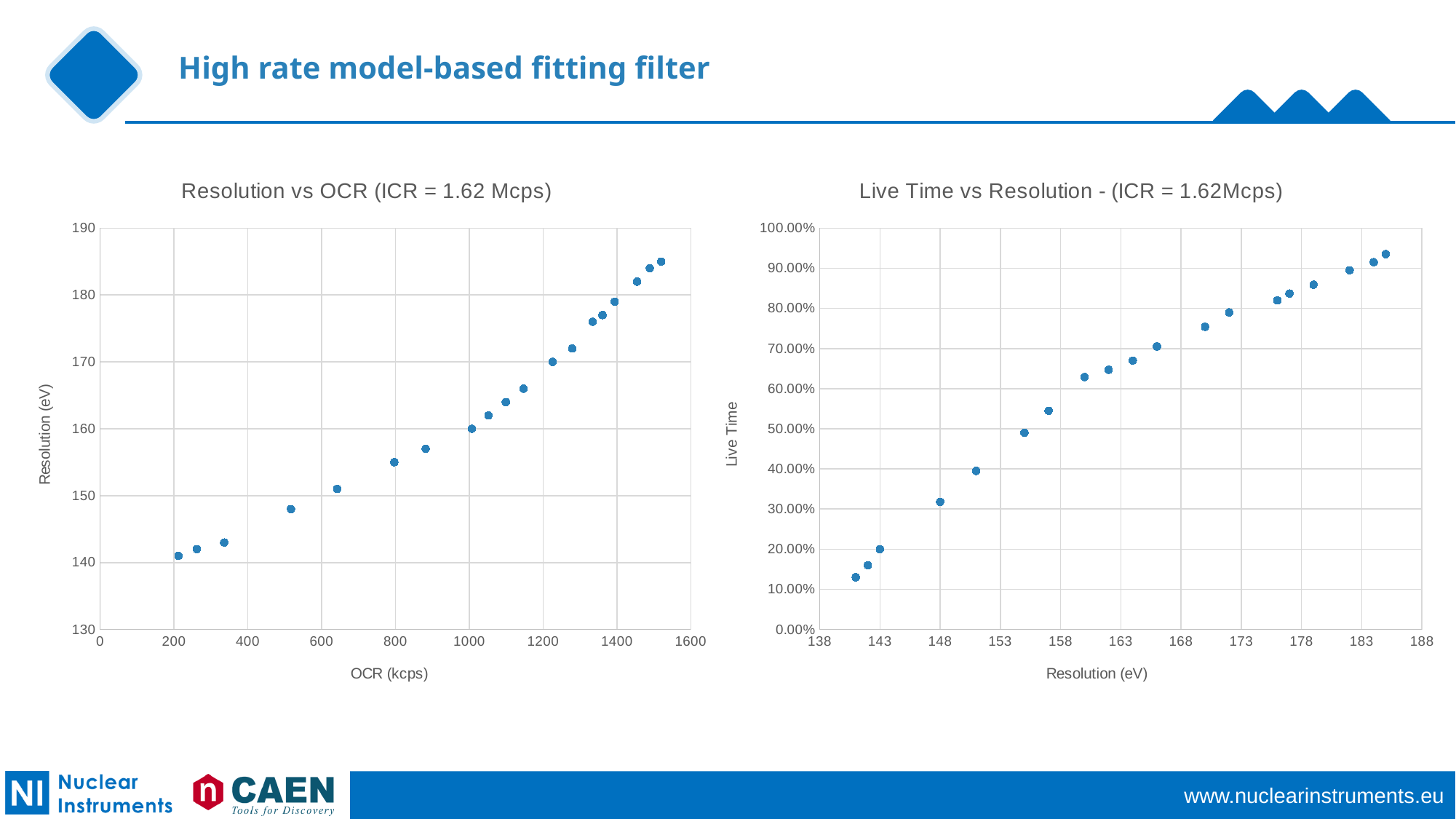
What is the x-axis label of the 'Resolution vs OCR' chart? OCR (kcps) What kind of chart is the 'Resolution vs OCR (ICR = 1.62 Mcps)' chart? scatter chart In the 'Live Time vs Resolution' chart, does live time rise or fall as resolution increases? rise In the 'Resolution vs OCR' chart, is the resolution at the highest OCR (around 1500 kcps) greater or less than 180 eV? greater What kind of chart is the 'Live Time vs Resolution - (ICR = 1.62Mcps)' chart? scatter chart In the 'Live Time vs Resolution' chart, is the live time at the lowest resolution (around 141 eV) greater or less than 20.00%? less What is the y-axis label of the 'Live Time vs Resolution' chart? Live Time In the 'Live Time vs Resolution' chart, is the live time at a resolution of about 148 eV greater or less than 40.00%? less In the 'Resolution vs OCR' chart, do the resolution values rise or fall as OCR increases? rise